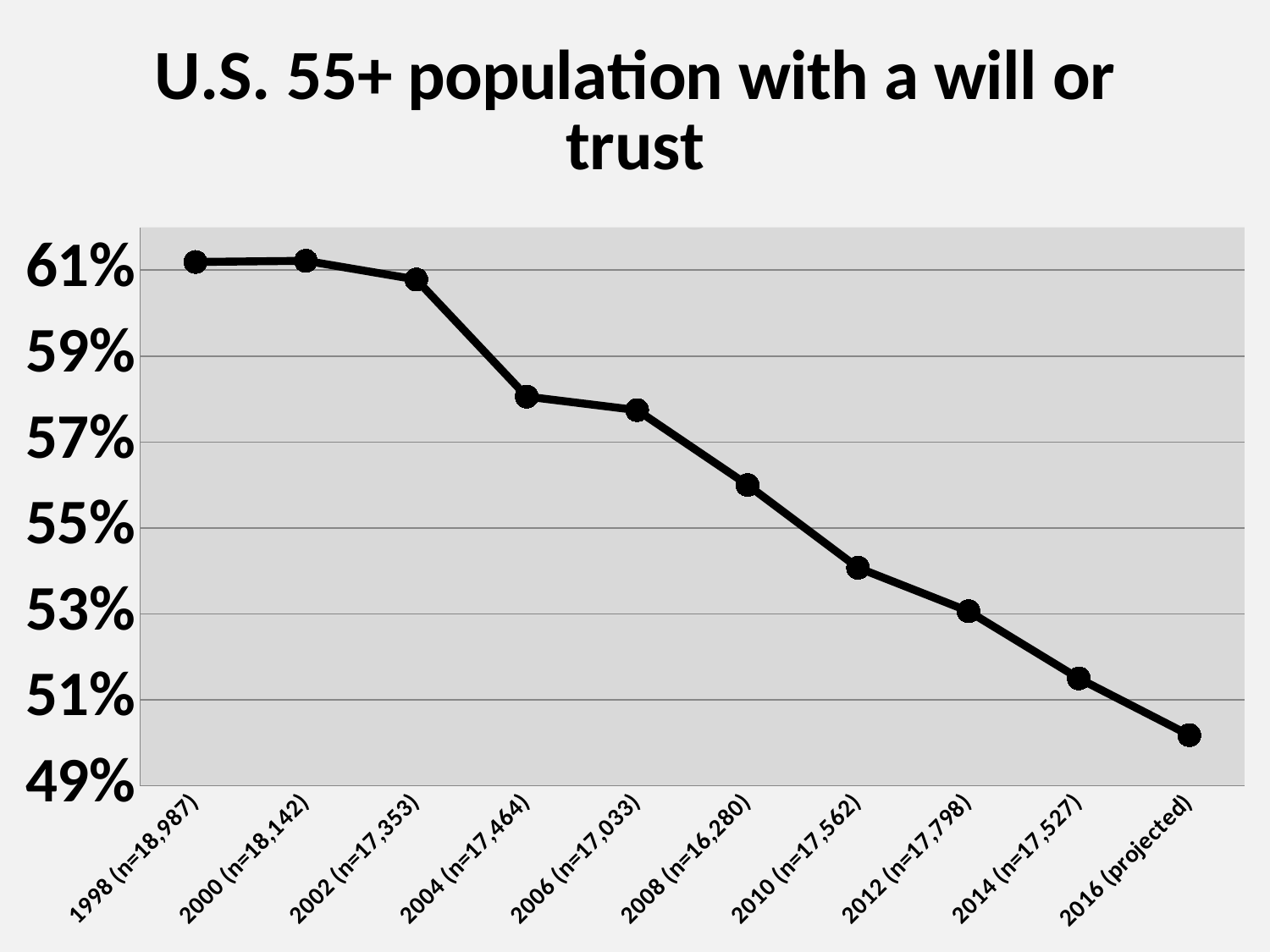
Which is larger, the value for 2004 (n=17,464) or the value for 2010 (n=17,562)? 2004 (n=17,464) What sample size is shown in the x-axis label for 1998? n=18,987 Is the value for 2002 (n=17,353) greater or less than 59%? greater Is the value for 2016 (projected) greater or less than 51%? less Do the values rise or fall from 1998 to 2016 (projected)? fall Is the value for 2010 (n=17,562) greater or less than 55%? less How many data points are plotted on the line? 10 What kind of chart is shown on the slide? line chart What is the title of the chart? U.S. 55+ population with a will or trust Which year has the lowest value? 2016 (projected)